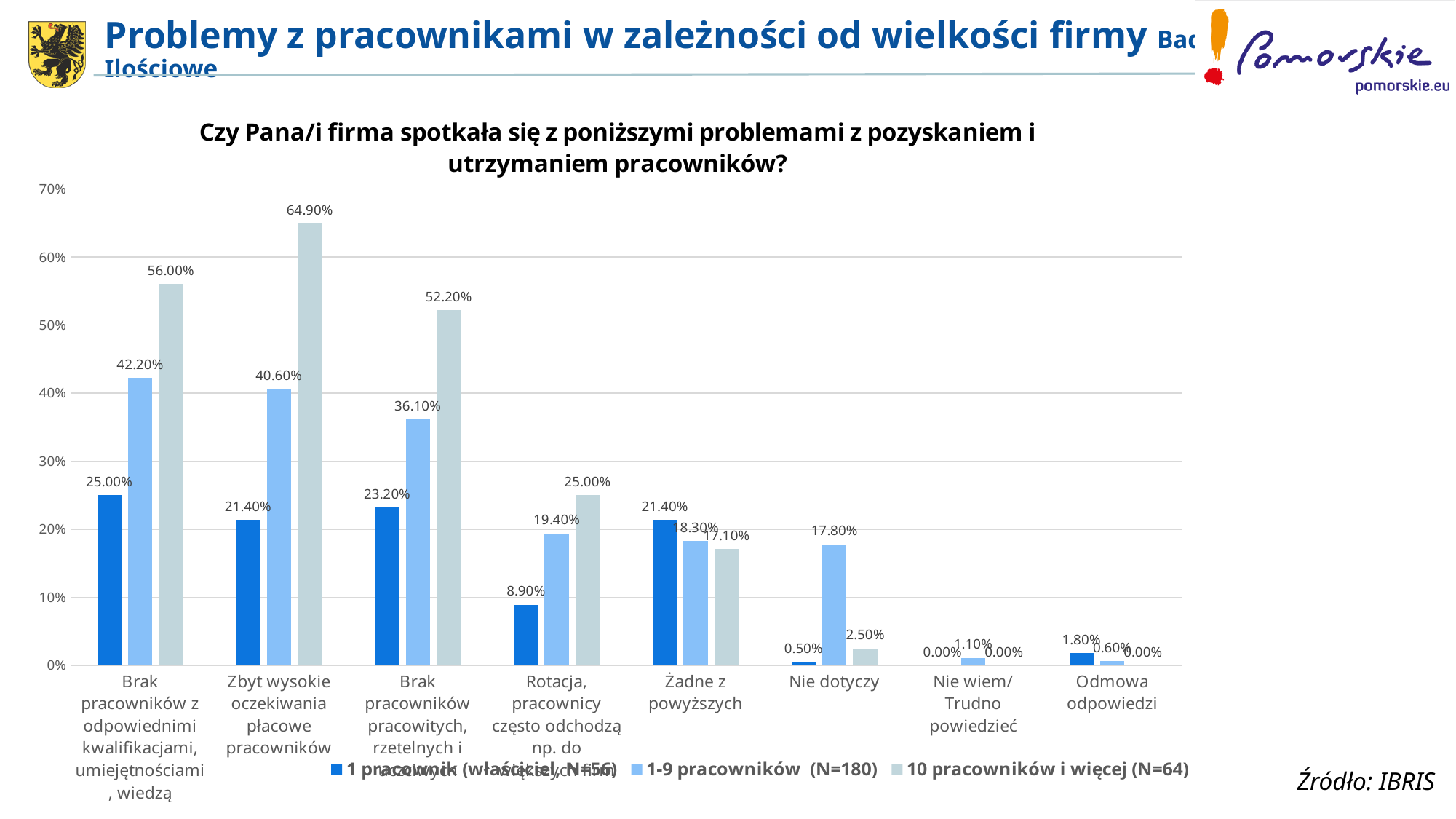
What is the value for "1-9 pracowników (N=180)" in the category "Nie dotyczy"? 17.80% How many categories are shown on the x axis? 8 Is the value for "1-9 pracowników (N=180)" in the category "Brak pracowników pracowitych, rzetelnych i uczciwych" greater or less than 30%? greater What is the difference between the "10 pracowników i więcej (N=64)" and "1 pracownik (właściciel, N=56)" values in the category "Brak pracowników z odpowiednimi kwalifikacjami, umiejętnościami, wiedzą"? 31.00% Which category has the highest value for the "10 pracowników i więcej (N=64)" series? Zbyt wysokie oczekiwania płacowe pracowników What kind of chart is shown on the slide? bar chart Which category has the lowest value for the "1-9 pracowników (N=180)" series? Odmowa odpowiedzi In the category "Żadne z powyższych", which series has the larger value: "1 pracownik (właściciel, N=56)" or "10 pracowników i więcej (N=64)"? 1 pracownik (właściciel, N=56) What is the value for "10 pracowników i więcej (N=64)" in the category "Zbyt wysokie oczekiwania płacowe pracowników"? 64.90% What is the source cited on the slide for the chart data? IBRIS How many series does the legend list? 3